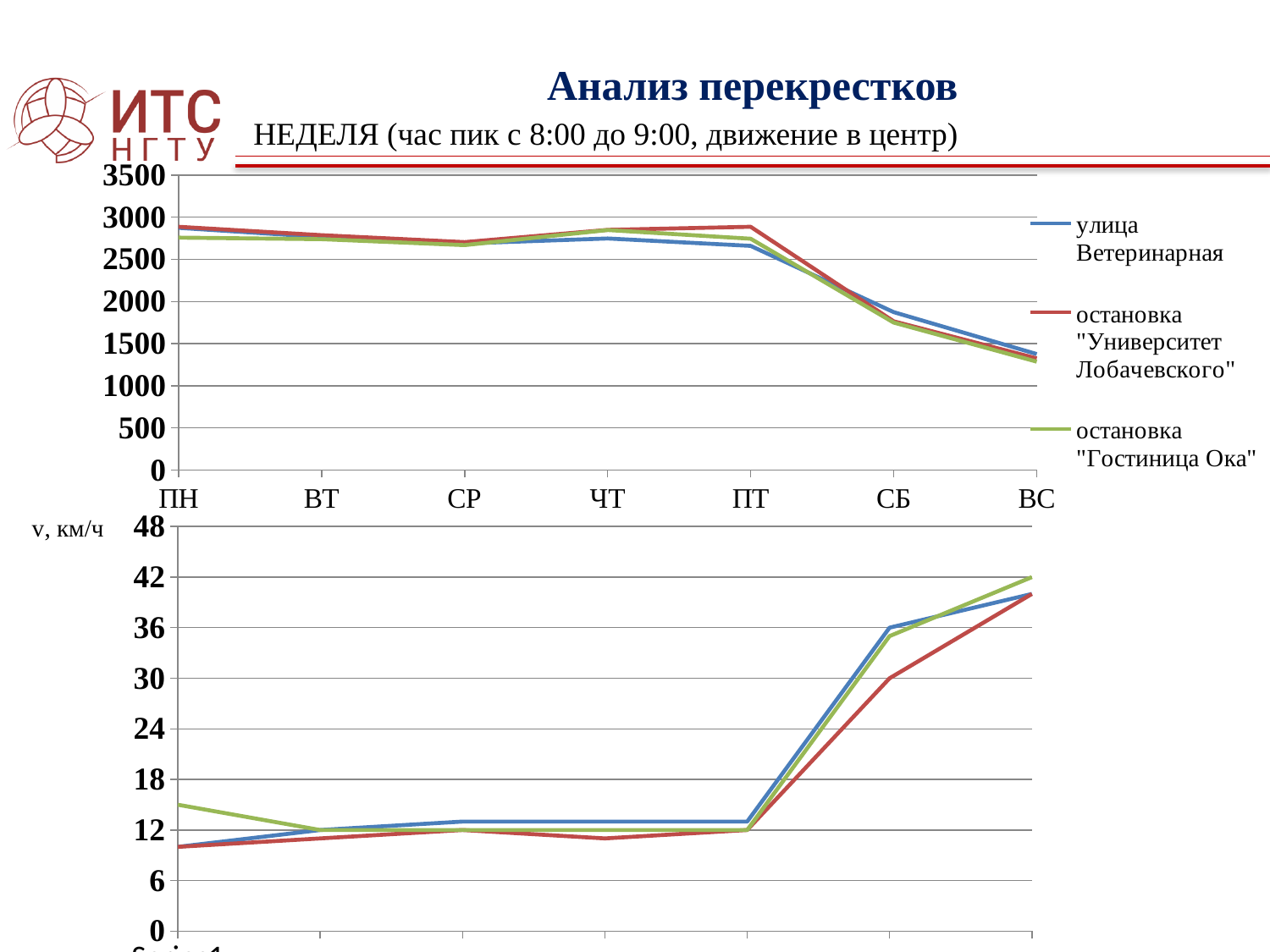
In the top chart, is the value for улица Ветеринарная at СБ greater or less than 2000? less In the top chart, is the value for остановка "Университет Лобачевского" at ПТ greater or less than 2500? greater In the top chart, is the value for улица Ветеринарная at ВС greater or less than 1500? less What kind of chart is the top chart on the slide? line chart In the top chart, which series has the lowest value at ПН? остановка "Гостиница Ока" How many categories are shown on the x axis of the top chart? 7 How many series does the legend of the top chart list? 3 In the top chart, do the values for остановка "Гостиница Ока" rise or fall from ПТ to ВС? fall In the bottom chart, do the values of the blue line rise or fall from the fifth point to the last point? rise What kind of chart is the bottom chart on the slide? line chart